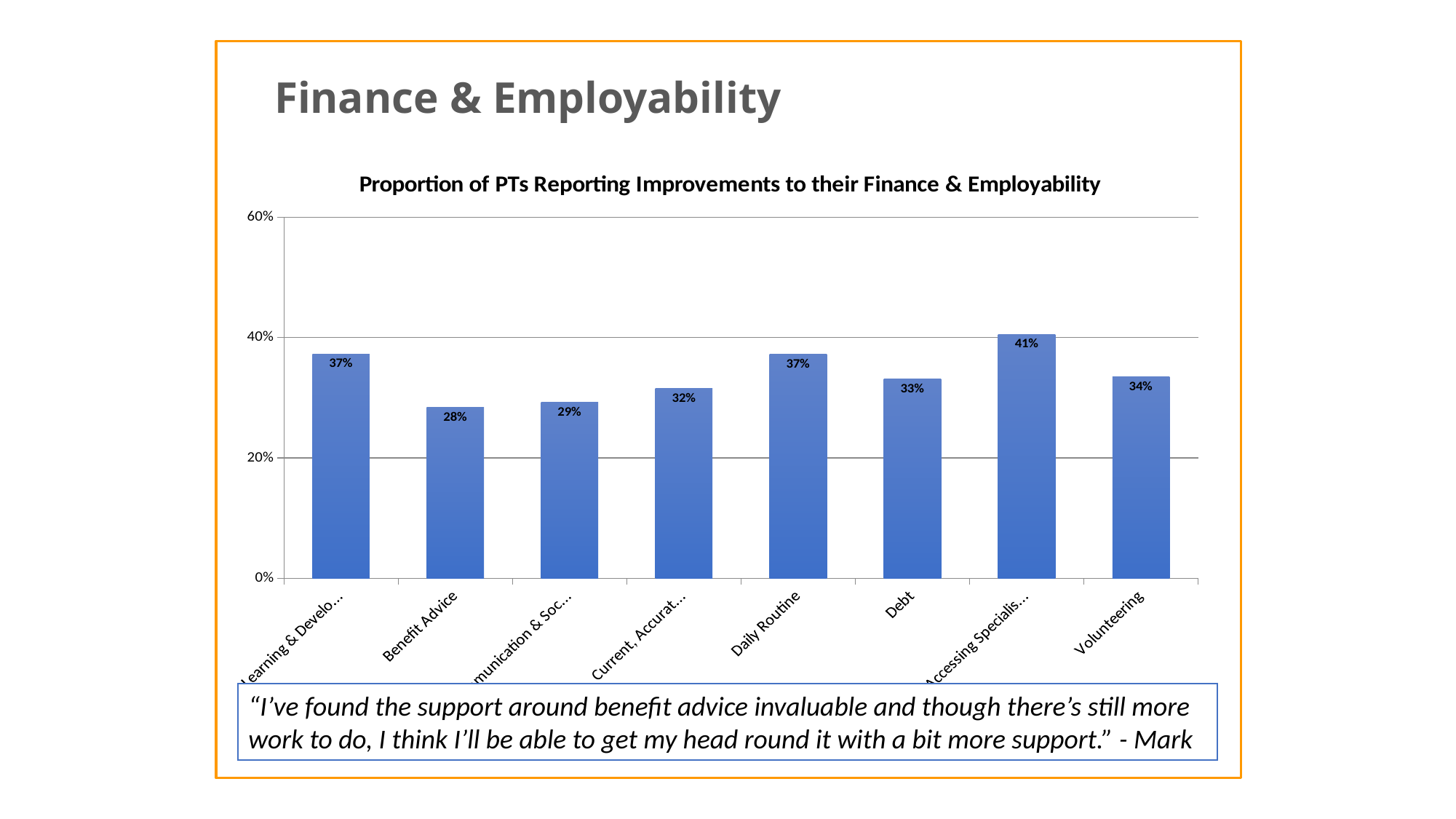
How many bars are shown in the chart? 8 Which category has the lowest value in the chart? Benefit Advice Which is larger, the value for Volunteering or the value for Debt? Volunteering What is the highest value shown on any bar in the chart? 41% What is the value for Daily Routine? 37% What is the value for Volunteering? 34% What is the title of the chart? Proportion of PTs Reporting Improvements to their Finance & Employability Is the value for Benefit Advice greater or less than 40%? less What is the difference between the values for Daily Routine and Debt? 4 percentage points What type of chart is shown on the slide? Bar chart What proportion of PTs reported improvements for Benefit Advice? 28% What is the value for Debt? 33%